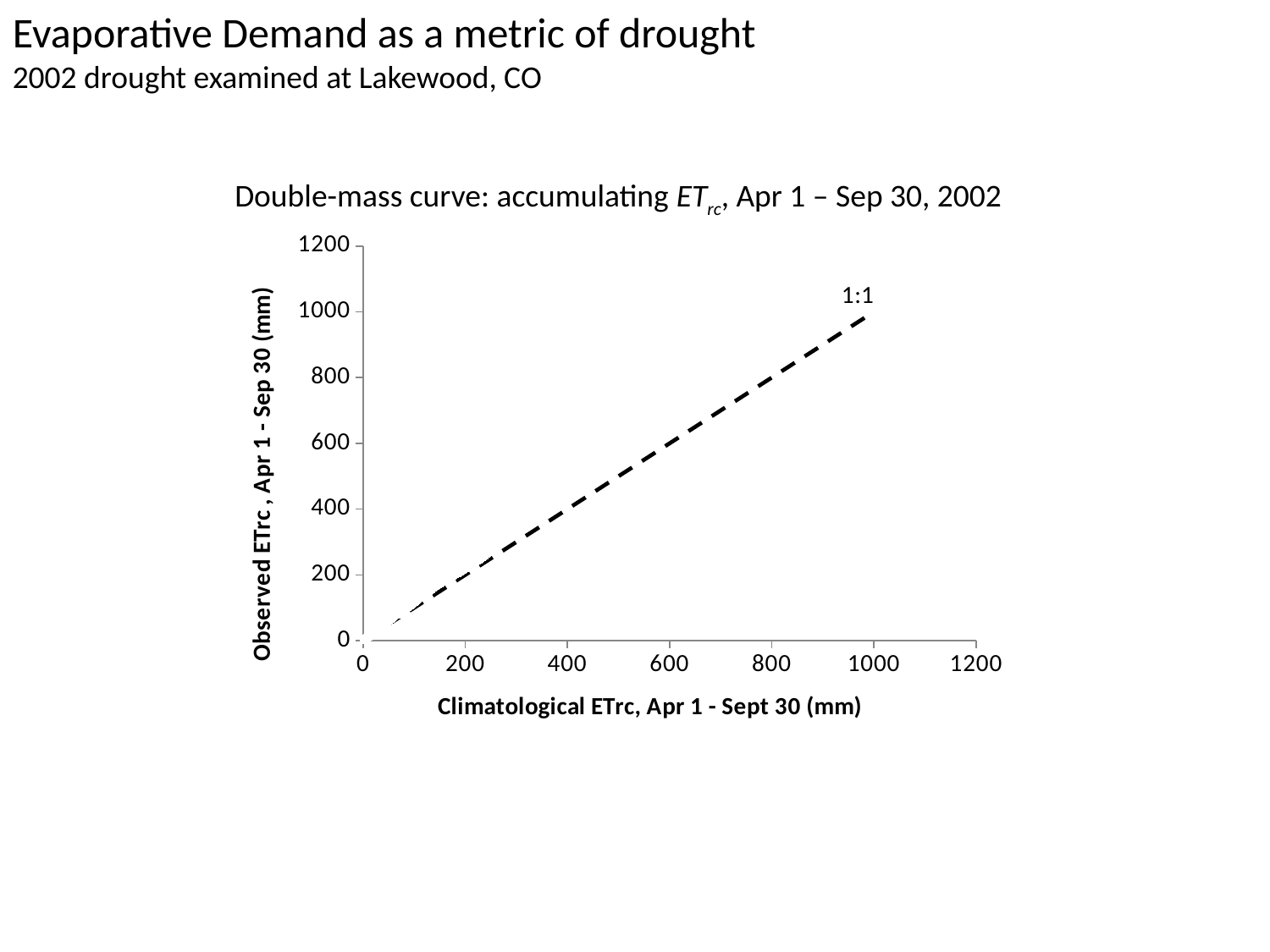
What is the title of the chart? Double-mass curve: accumulating ETrc, Apr 1 – Sep 30, 2002 Does the dashed 1:1 line rise or fall as Climatological ETrc increases along the x axis? rises At a Climatological ETrc of 600 mm, is the value of the dashed 1:1 line greater or less than 400? greater What kind of chart is shown on the slide? line chart What is the highest value shown on the x axis of the chart? 1200 What is the highest value shown on the y axis of the chart? 1200 What label is printed next to the dashed line on the chart? 1:1 What is the lowest value shown on the y axis of the chart? 0 How many lines are plotted on the chart? 1 At a Climatological ETrc of 800 mm, is the value of the dashed 1:1 line greater or less than 1000? less